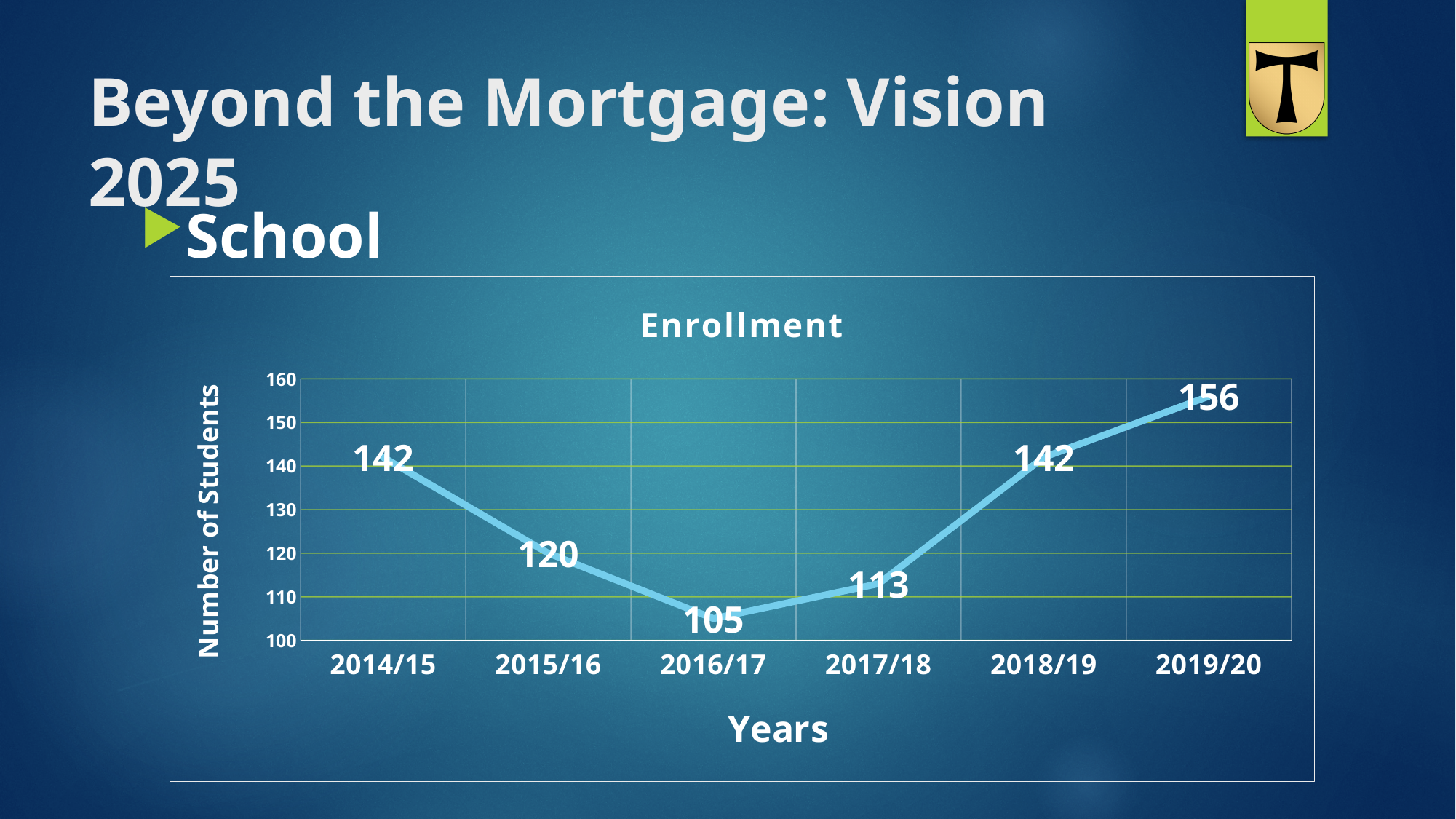
What is the difference in enrollment between 2014/15 and 2015/16? 22 What is the title of the chart? Enrollment How many years are plotted on the chart? 6 Which year has a larger enrollment, 2015/16 or 2017/18? 2015/16 Which year has the lowest enrollment? 2016/17 What is the enrollment value for 2016/17? 105 What is the enrollment value for 2017/18? 113 Which year has the highest enrollment? 2019/20 What kind of chart is shown on the slide? Line chart What is the enrollment value for 2019/20? 156 What is the difference in enrollment between 2019/20 and 2016/17? 51 Does enrollment rise or fall from 2016/17 to 2019/20? Rise